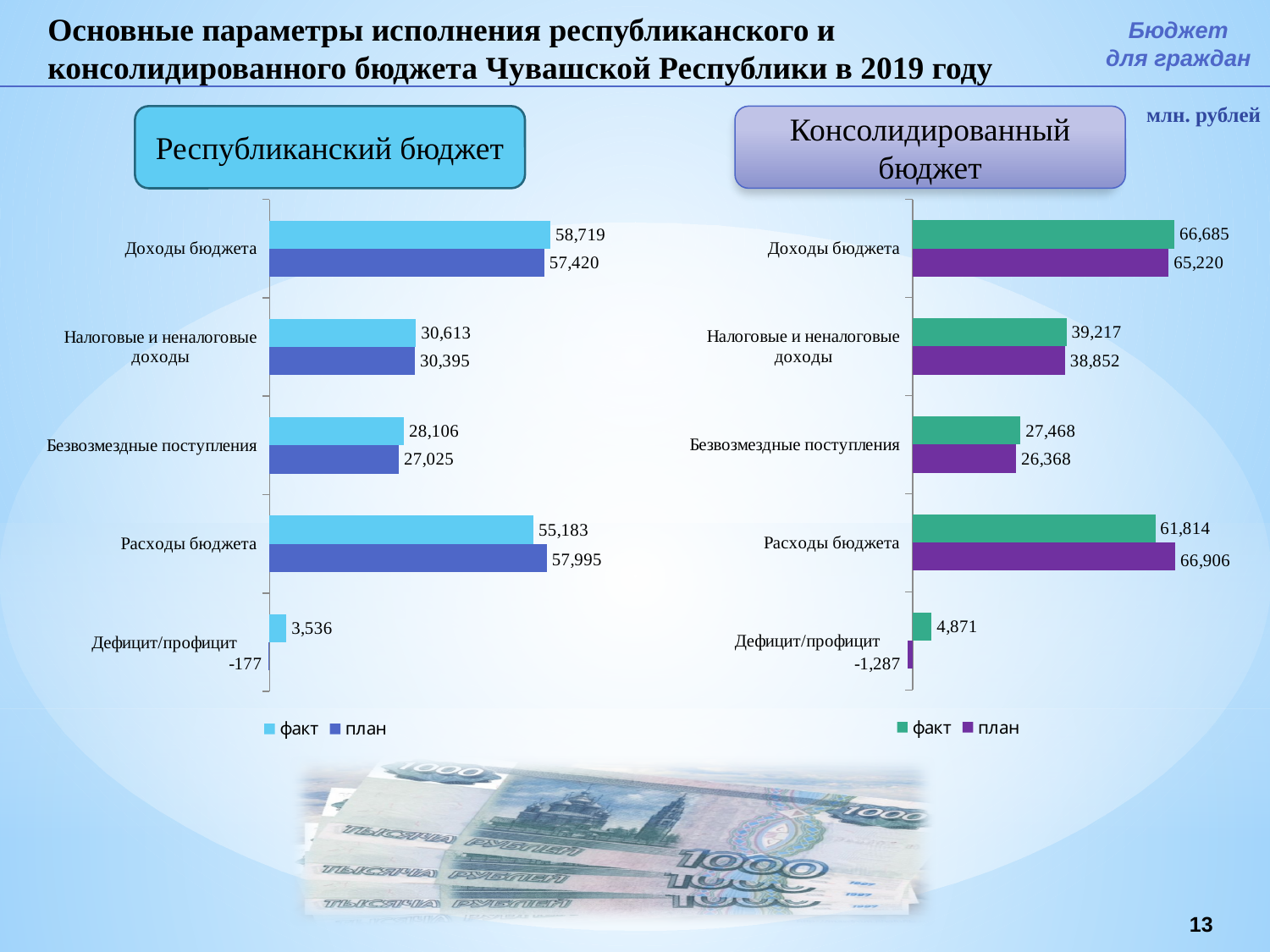
How many series does the legend of the Консолидированный бюджет chart list? 2 In the Республиканский бюджет chart, what is the difference between the план and факт values for Расходы бюджета? 2,812 In the Консолидированный бюджет chart, what is the факт value for Безвозмездные поступления? 27,468 How many categories are shown in the Республиканский бюджет chart? 5 In the Консолидированный бюджет chart, what is the план value for Расходы бюджета? 66,906 In the Республиканский бюджет chart, which category has the highest факт value? Доходы бюджета What type of chart is the Республиканский бюджет chart? bar chart In the Республиканский бюджет chart, what is the факт value for Доходы бюджета? 58,719 In the Консолидированный бюджет chart, which is larger for Доходы бюджета: факт or план? факт What unit of measurement is indicated for the charts on the slide? млн. рублей In the Республиканский бюджет chart, what is the план value for Дефицит/профицит? -177 In the Консолидированный бюджет chart, which category has the lowest план value? Дефицит/профицит